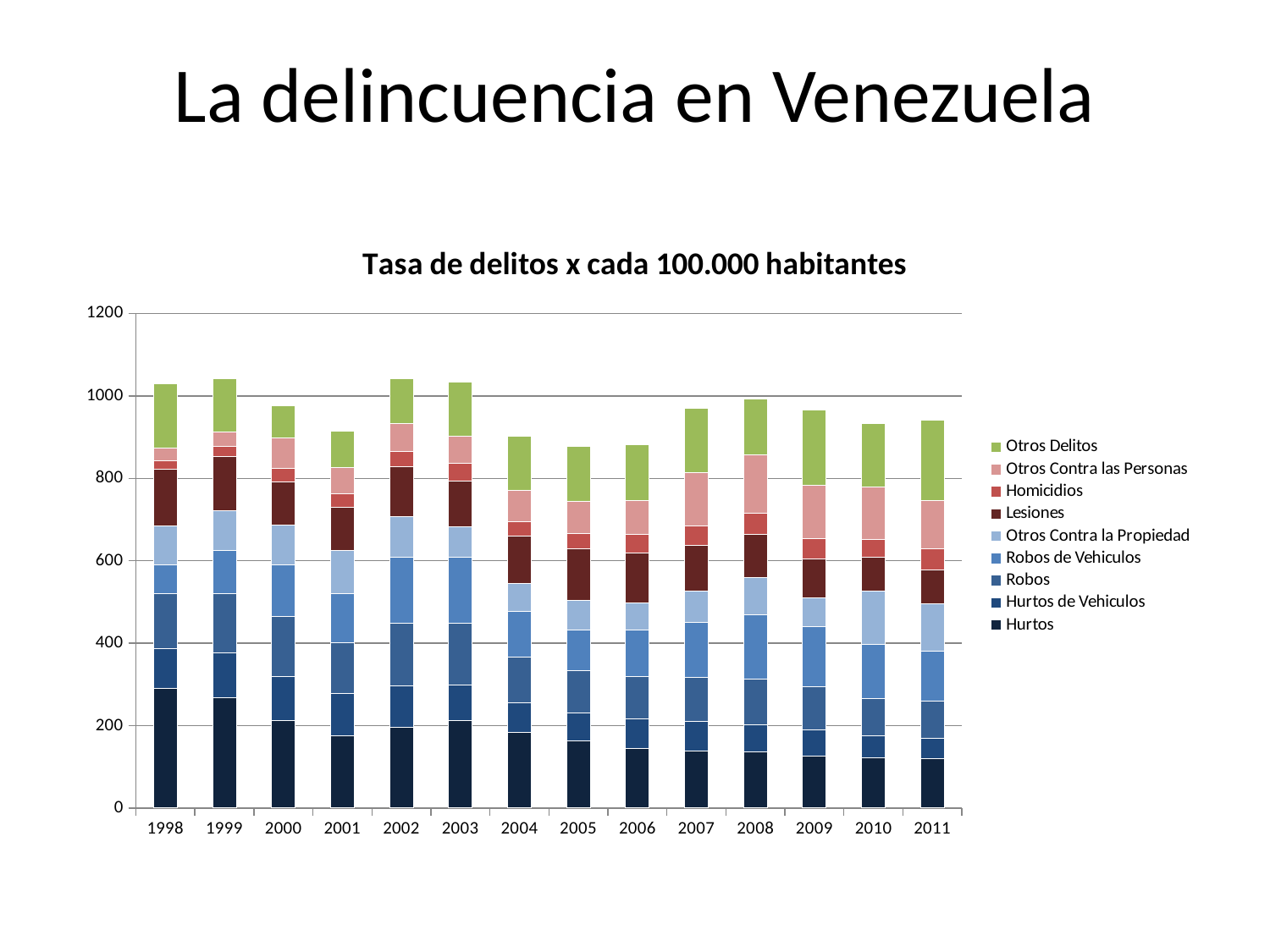
Is the Hurtos value for 2011 greater or less than 200? less Which year has the larger Hurtos value, 1998 or 2005? 1998 Does the Hurtos segment generally rise or fall from 1998 to 2011? fall How many years are shown along the x axis of the chart? 14 Is the Hurtos value for 1998 greater or less than 200? greater Is the total height of the stacked bar for 1998 greater or less than 1000? greater Which year has the taller stacked bar overall, 1998 or 2011? 1998 What kind of chart is shown on the slide? Stacked bar chart Which series is listed first (at the top) in the chart's legend? Otros Delitos What is the title of the chart? Tasa de delitos x cada 100.000 habitantes How many series does the chart's legend list? 9